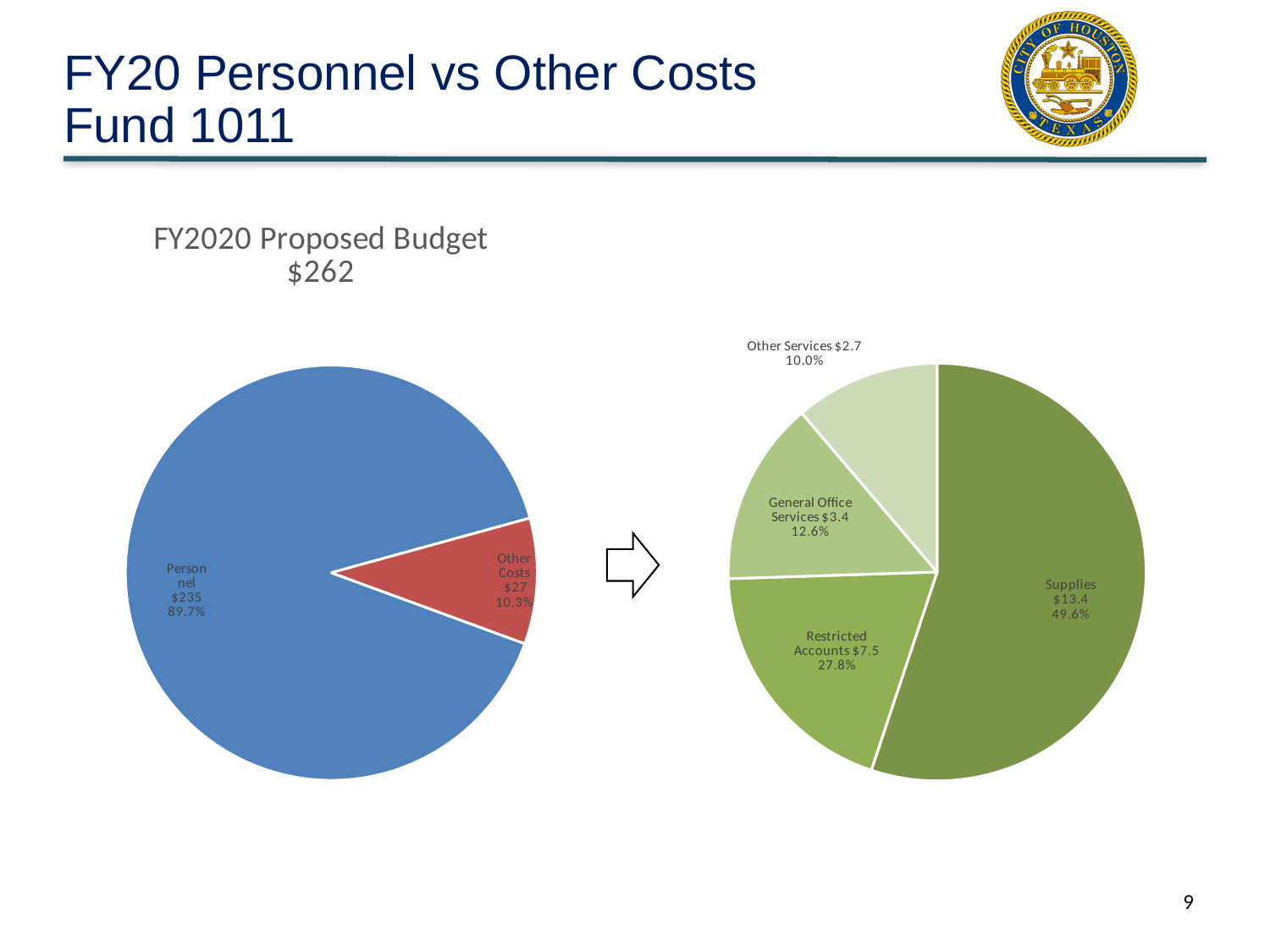
In the right pie chart, which category has the smallest slice? Other Services In the left pie chart titled 'FY2020 Proposed Budget $262', how many slices does the pie have? 2 In the left pie chart titled 'FY2020 Proposed Budget $262', what is the value for Personnel? $235 In the right pie chart, what share of the pie is General Office Services? 12.6% In the left pie chart titled 'FY2020 Proposed Budget $262', what is the difference between the Personnel and Other Costs values? $208 What kind of chart is the chart on the right side of the slide? Pie chart In the left pie chart titled 'FY2020 Proposed Budget $262', what share of the pie is Other Costs? 10.3% In the left pie chart titled 'FY2020 Proposed Budget $262', what share of the pie is Personnel? 89.7% In the right pie chart, what is the value for Restricted Accounts? $7.5 In the right pie chart, how many categories are shown? 4 In the right pie chart, which category has the largest slice? Supplies In the right pie chart, what is the value for Supplies? $13.4